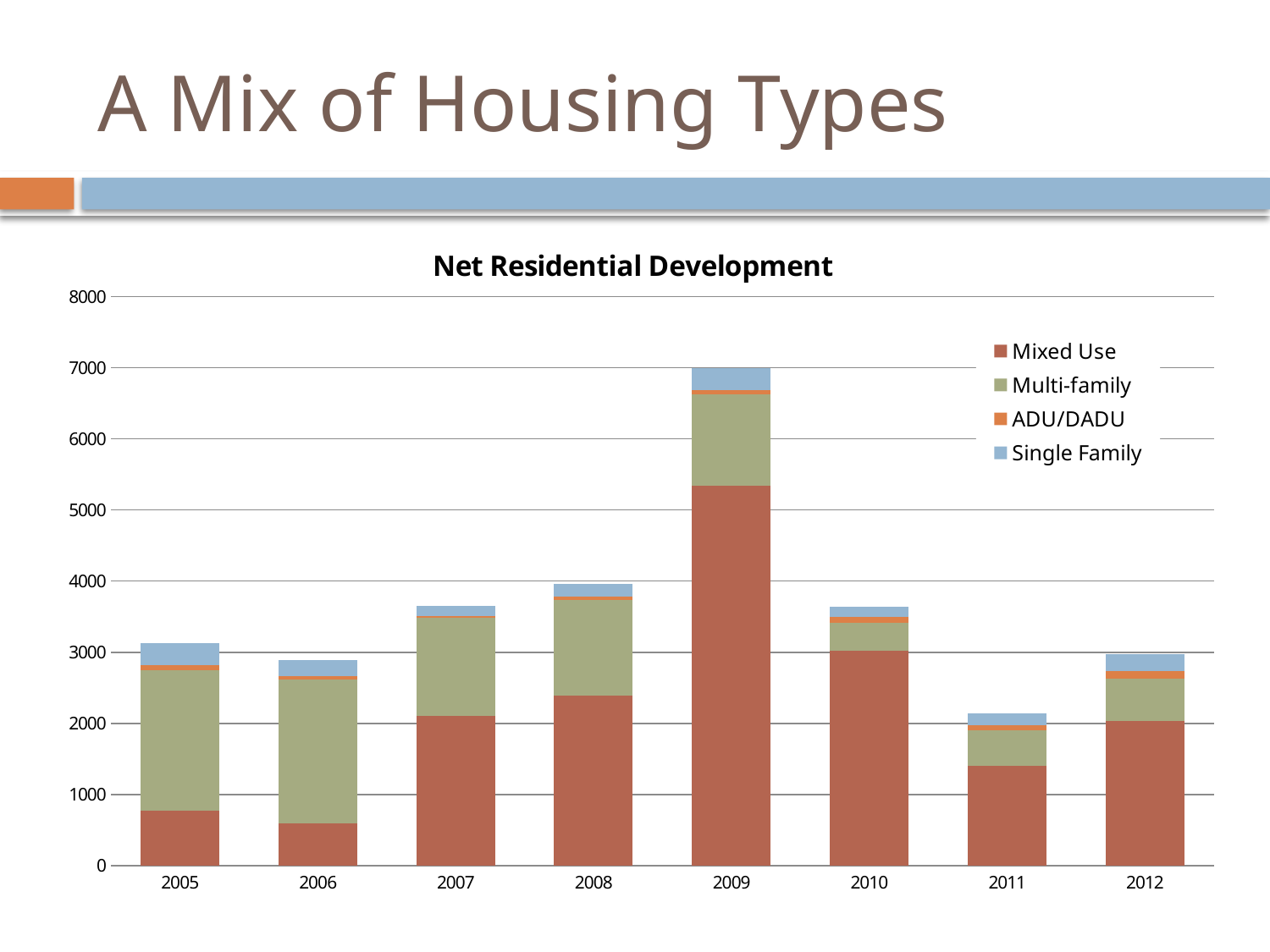
How many series does the legend list? 4 Is the Mixed Use value for 2005 greater or less than 1000? less Do the total values rise or fall from 2009 to 2011? fall Which year has a larger total, 2006 or 2011? 2006 Is the total for 2009 greater or less than 6000? greater How many years are shown on the x axis? 8 What kind of chart is shown on the slide? Stacked bar chart Which year has the lowest total net residential development? 2011 Which year has the highest total net residential development? 2009 What is the title of the chart? Net Residential Development Is the Mixed Use value for 2009 greater or less than 5000? greater